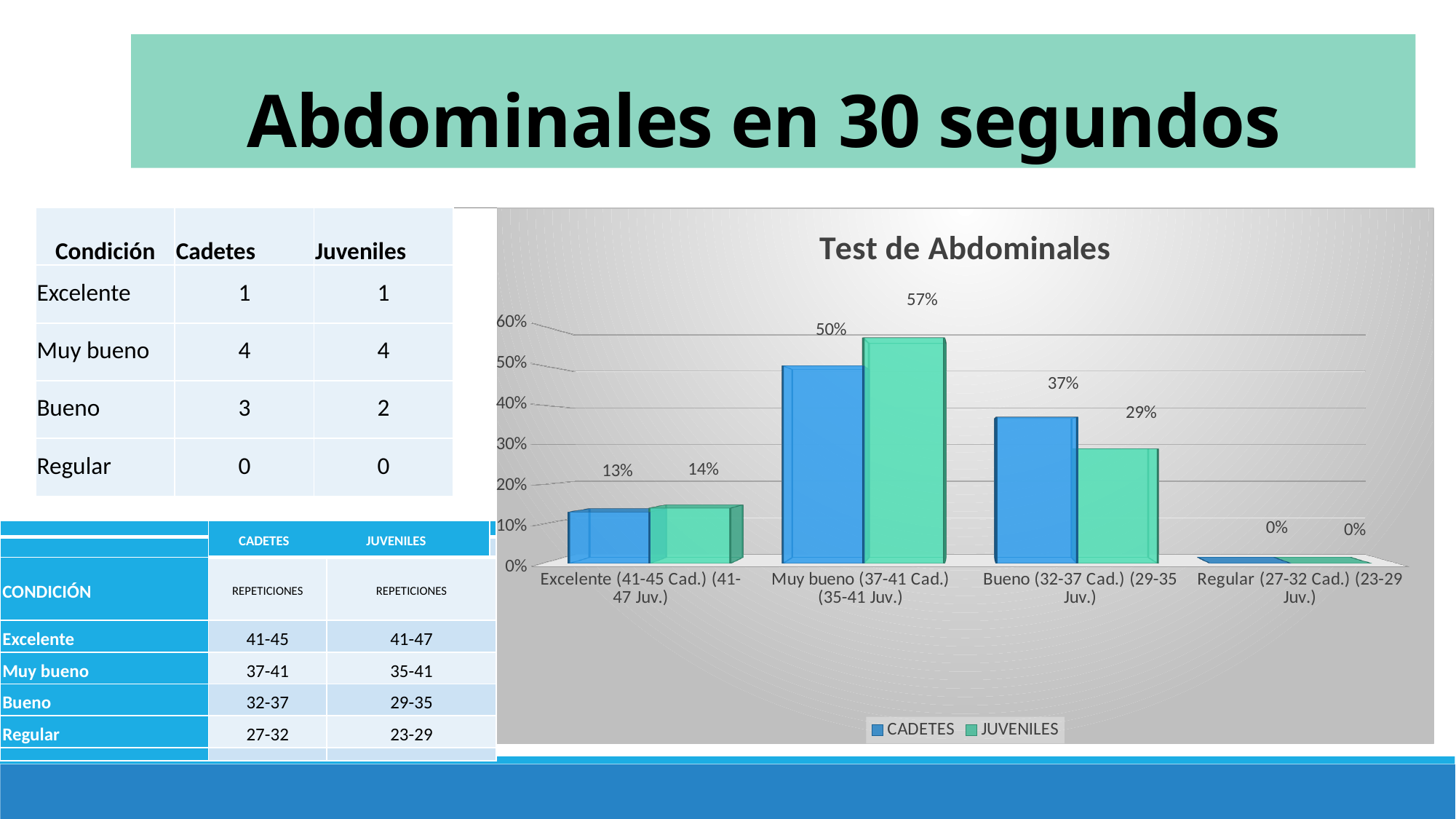
How many categories are shown on the x axis of the chart? 4 Is the value for CADETES in the Bueno category greater or less than 30%? greater What is the value for CADETES in the Regular category? 0% Which category has the lowest value for CADETES? Regular What is the title of the chart? Test de Abdominales What is the value for JUVENILES in the Bueno category? 29% What is the difference between the CADETES and JUVENILES values in the Bueno category? 8% What is the value for JUVENILES in the Excelente category? 14% Which category has the highest value for JUVENILES? Muy bueno What is the value for CADETES in the Muy bueno category? 50% How many series does the chart legend list? 2 Which is larger in the Muy bueno category, CADETES or JUVENILES? JUVENILES